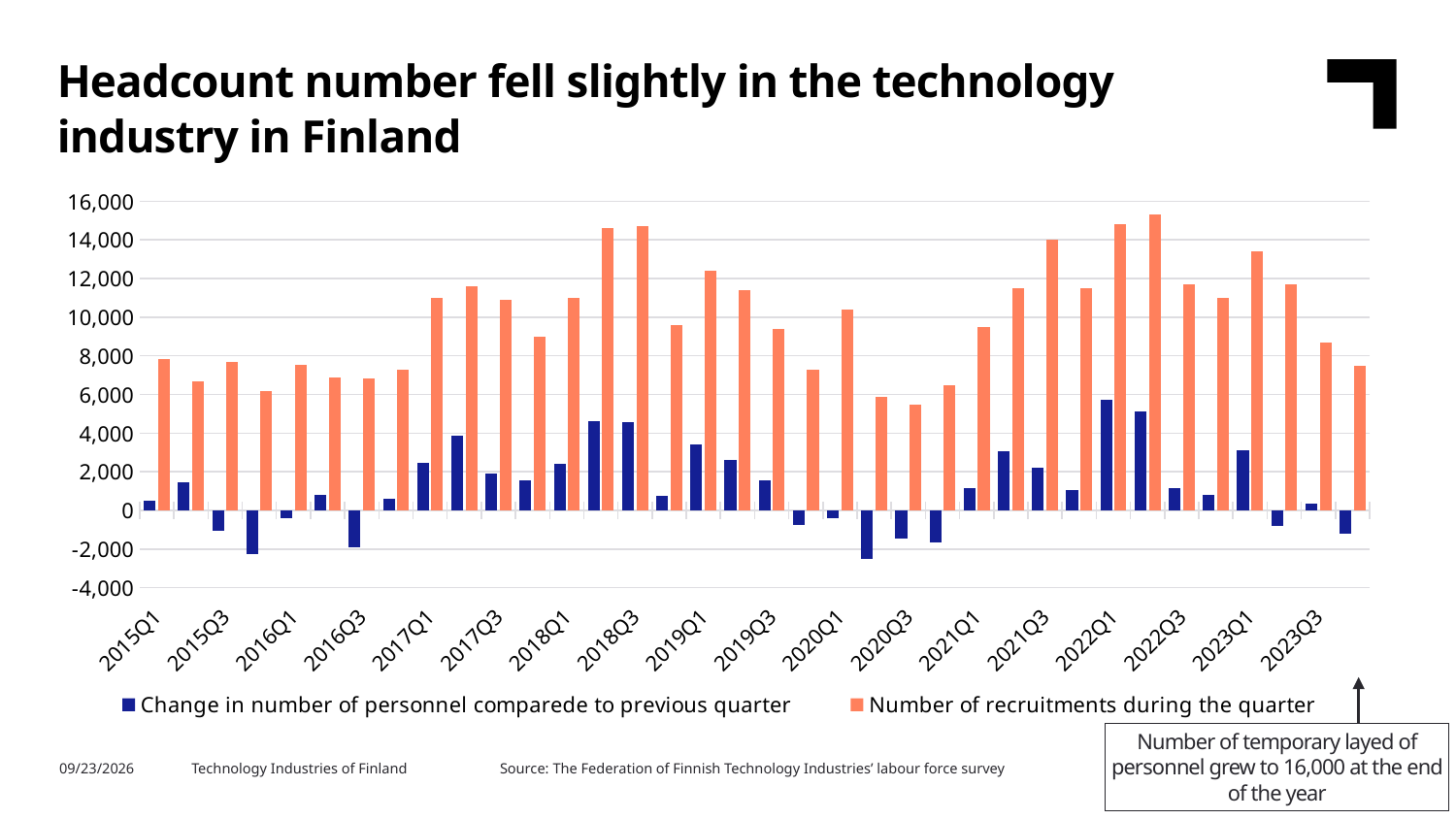
Is the change in number of personnel in 2022Q1 greater or less than 4,000? greater What are the two series named in the legend? Change in number of personnel comparede to previous quarter; Number of recruitments during the quarter Is the change in number of personnel in 2015Q3 greater or less than 0? less Which quarter had more recruitments, 2018Q3 or 2015Q1? 2018Q3 Is the number of recruitments in 2018Q3 greater or less than 12,000? greater Which quarter had more recruitments, 2017Q1 or 2020Q3? 2017Q1 How many series does the legend list? 2 What kind of chart is shown on the slide? Bar chart Which colour represents the number of recruitments during the quarter? Orange